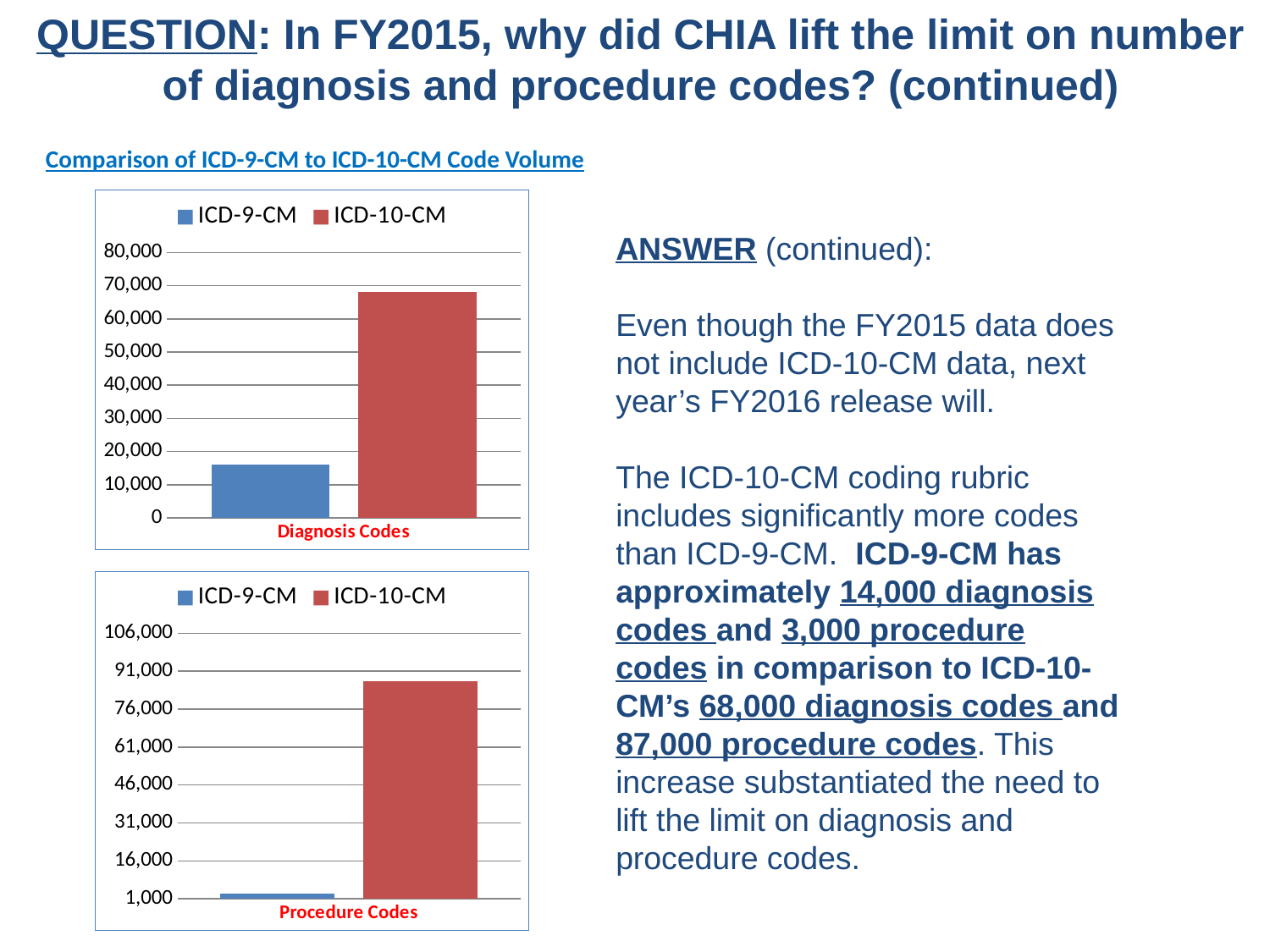
What colour are the ICD-10-CM bars in both charts? red What is the category label shown on the x axis of the bottom chart? Procedure Codes In the top chart (Diagnosis Codes), which series has the taller bar, ICD-9-CM or ICD-10-CM? ICD-10-CM What kind of chart is the top chart (Diagnosis Codes)? bar chart In the top chart (Diagnosis Codes), is the value for ICD-10-CM greater or less than 60,000? greater In the bottom chart (Procedure Codes), is the value for ICD-9-CM greater or less than 16,000? less In the bottom chart (Procedure Codes), is the value for ICD-10-CM greater or less than 91,000? less In the bottom chart (Procedure Codes), which series has the lowest bar? ICD-9-CM How many series does the legend of the top chart (Diagnosis Codes) list? 2